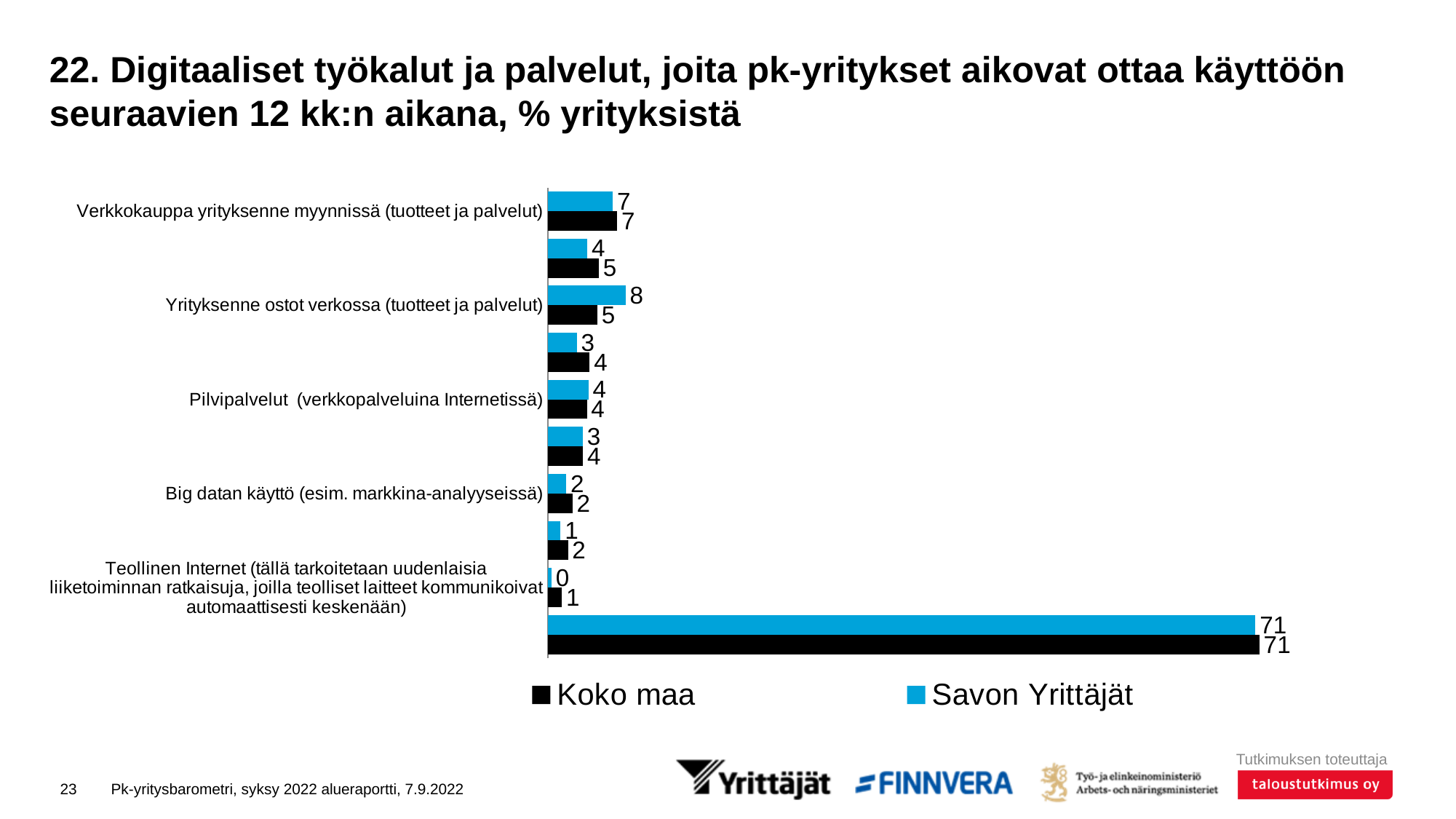
Which colour represents the Koko maa series? Black What is the difference between the Savon Yrittäjät and Koko maa values for 'Yrityksenne ostot verkossa (tuotteet ja palvelut)'? 3 What is the value for Savon Yrittäjät for 'Teollinen Internet'? 0 What kind of chart is shown on the slide? Bar chart What is the value for Koko maa for 'Big datan käyttö (esim. markkina-analyyseissä)'? 2 How many series does the legend list? 2 Which series has the larger value for 'Yrityksenne ostot verkossa (tuotteet ja palvelut)', Koko maa or Savon Yrittäjät? Savon Yrittäjät What is the value for Koko maa for 'Verkkokauppa yrityksenne myynnissä (tuotteet ja palvelut)'? 7 What is the value for Koko maa for 'Yrityksenne ostot verkossa (tuotteet ja palvelut)'? 5 What is the value for Savon Yrittäjät for 'Pilvipalvelut (verkkopalveluina Internetissä)'? 4 For 'Teollinen Internet', which series has the larger value, Koko maa or Savon Yrittäjät? Koko maa What is the value for Savon Yrittäjät for 'Yrityksenne ostot verkossa (tuotteet ja palvelut)'? 8